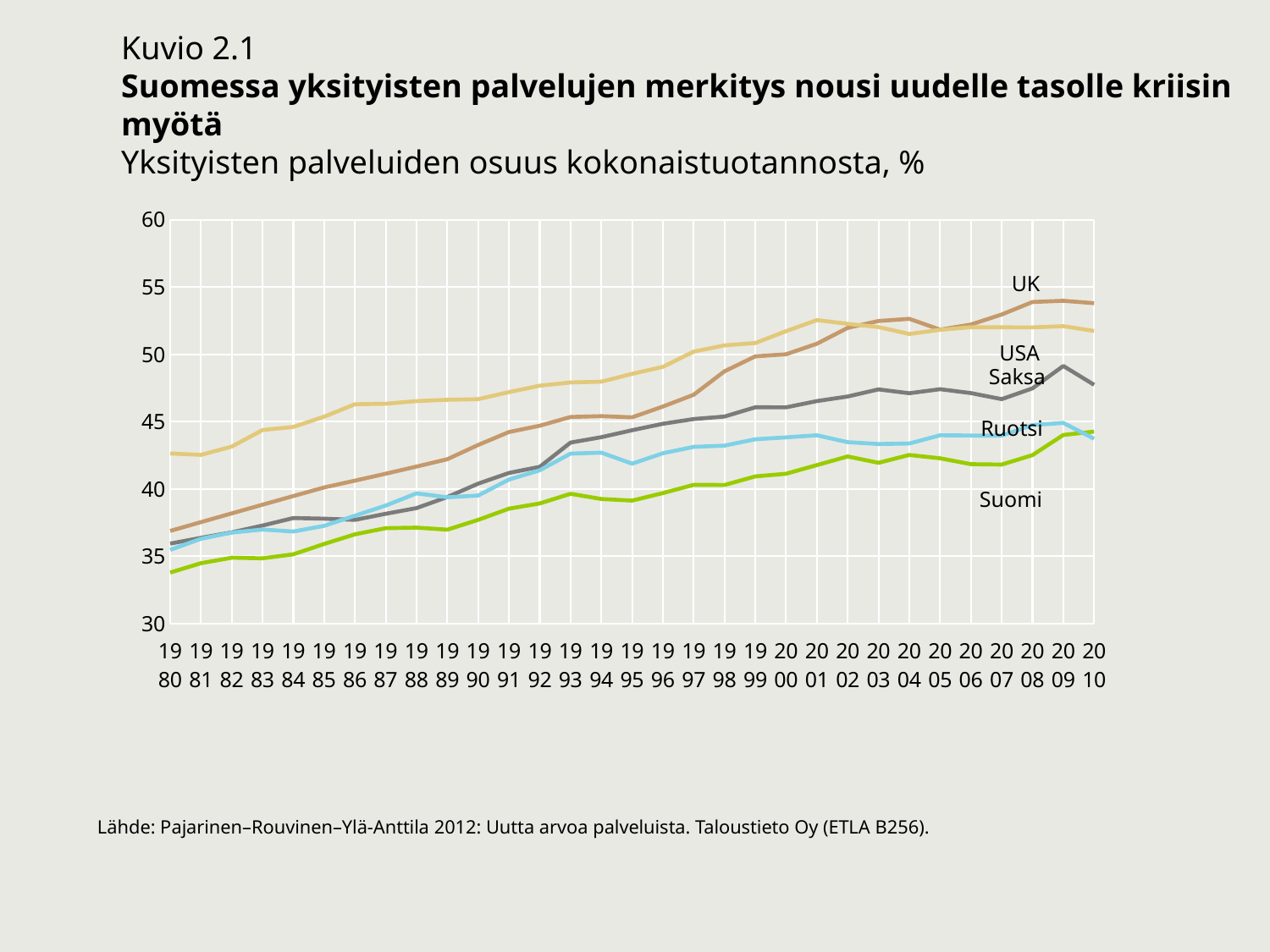
Which is larger in 1990, the value for USA or the value for Saksa? USA Does the value for Suomi generally rise or fall from 1980 to 2010? rise What is the subtitle describing the measure plotted on the chart? Yksityisten palveluiden osuus kokonaistuotannosta, % Which country has the lowest value in 1980? Suomi How many years are shown along the x axis of the chart? 31 Is the value for Suomi in 1980 greater or less than 35? less How many countries (series) are plotted on the chart? 5 Which country has the highest value in 2010? UK Is the value for UK in 2010 greater or less than 50? greater Which country has the highest value in 1980? USA Is the value for Saksa in 2010 greater or less than 45? greater What kind of chart is shown on the slide? line chart